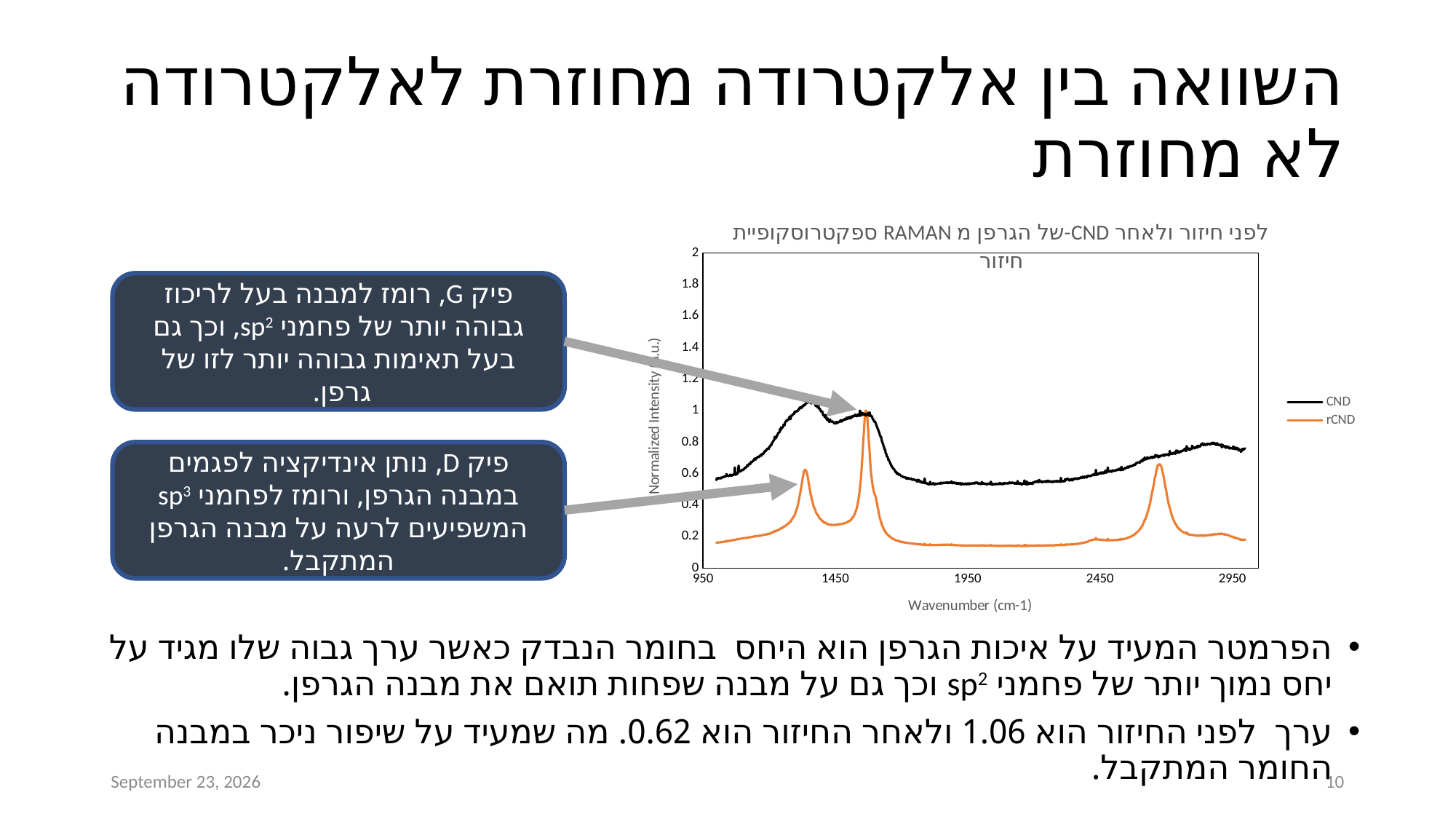
What are the two series named in the chart legend? CND and rCND What is the label of the x axis of the chart? Wavenumber (cm-1) What colour is the rCND line in the chart? orange Is the value of the rCND line at a wavenumber of 1950 greater or less than 0.4? less Is the value of the rCND line at a wavenumber of 2950 greater or less than 0.4? less At a wavenumber of 1950, which series has the higher value, CND or rCND? CND Between wavenumbers 2450 and 2850, does the CND line rise or fall? rise What kind of chart is shown on the slide? line chart How many series does the chart legend list? 2 Is the value of the CND line at a wavenumber of 1950 greater or less than 1? less